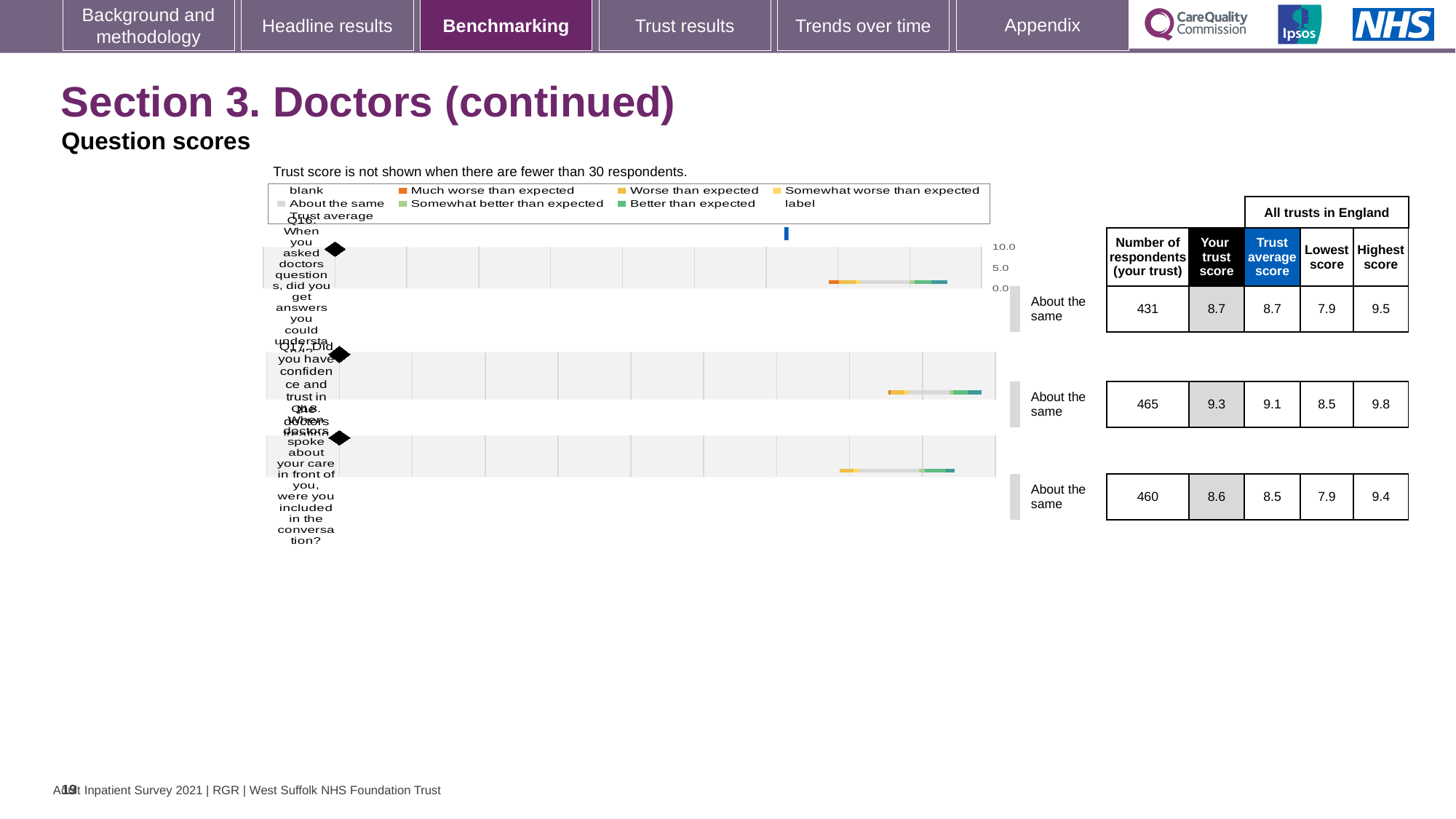
What benchmark category is shown for Q16? About the same For Q18, which is larger: your trust score or the trust average score? Your trust score Which question has the highest 'Your trust score'? Q17 What is the 'Your trust score' for Q17 (Did you have confidence and trust in the doctors treating you)? 9.3 What is the trust average score for Q18? 8.5 What kind of chart is shown on the slide? Bar chart Which question has the lowest 'Your trust score'? Q18 What is the highest score across all trusts in England for Q18? 9.4 How many respondents from your trust answered Q16? 431 How many questions are plotted in the chart? 3 What is the difference between the highest score and the lowest score for Q17? 1.3 How many more respondents answered Q17 than Q16? 34